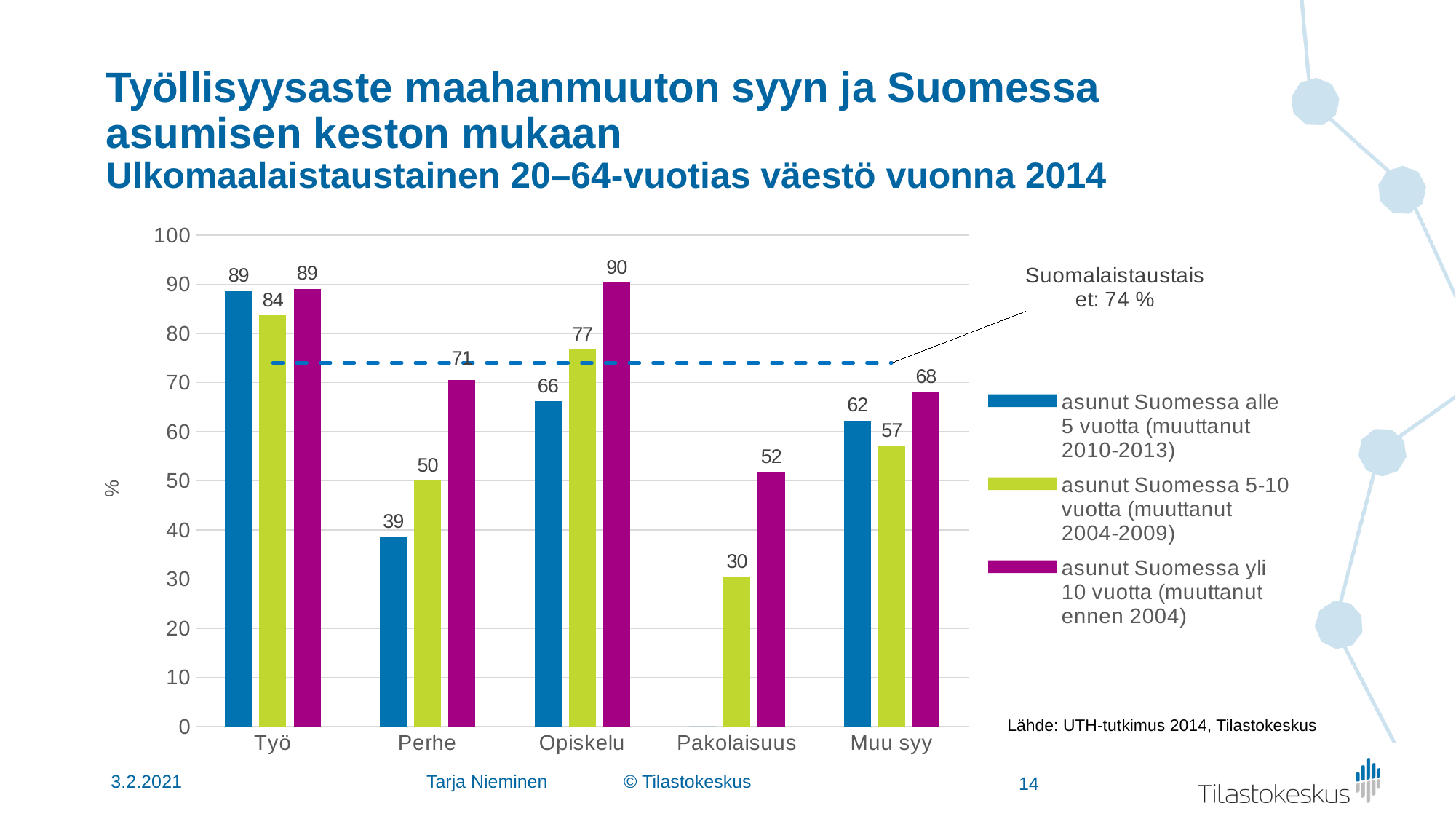
What is the difference between the 'asunut Suomessa yli 10 vuotta' value and the 'asunut Suomessa 5-10 vuotta' value for Pakolaisuus? 22 Which category has the highest value in the series 'asunut Suomessa yli 10 vuotta (muuttanut ennen 2004)'? Opiskelu What value does the dashed horizontal line for Suomalaistaustaiset represent? 74 % What is the value for Muu syy in the series 'asunut Suomessa alle 5 vuotta (muuttanut 2010-2013)'? 62 What is the difference between the 'asunut Suomessa yli 10 vuotta' value and the 'asunut Suomessa alle 5 vuotta' value for Perhe? 32 How many categories are shown on the x axis? 5 How many series does the legend list? 3 What is the value for Pakolaisuus in the series 'asunut Suomessa 5-10 vuotta (muuttanut 2004-2009)'? 30 For Opiskelu, which is larger: the 'asunut Suomessa alle 5 vuotta' value or the 'asunut Suomessa 5-10 vuotta' value? asunut Suomessa 5-10 vuotta What is the value for Perhe in the series 'asunut Suomessa yli 10 vuotta (muuttanut ennen 2004)'? 71 What kind of chart is shown on the slide? bar chart Which category has the lowest value in the series 'asunut Suomessa 5-10 vuotta (muuttanut 2004-2009)'? Pakolaisuus